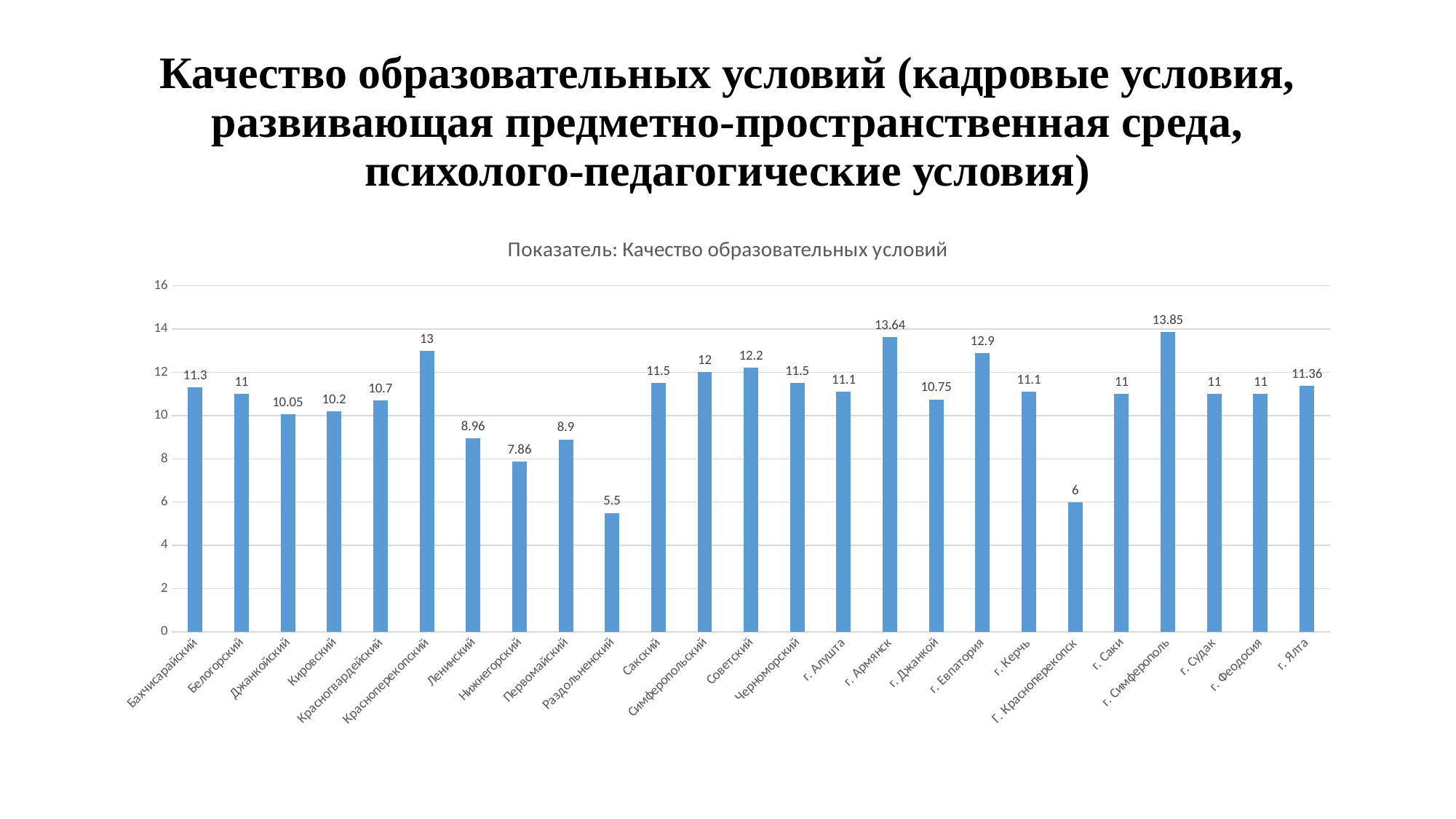
What is the difference between the values for г. Симферополь and Раздольненский? 8.35 What is the value for г. Армянск? 13.64 What is the difference between the values for Красноперекопский and Ленинский? 4.04 What is the value for Нижнегорский? 7.86 What kind of chart is shown on the slide? bar chart Which is larger, the value for Советский or the value for Нижнегорский? Советский Which category has the highest value? г. Симферополь Is the value for г. Красноперекопск greater or less than 8? less Which category has the lowest value? Раздольненский How many categories are shown on the x axis? 25 What is the title of the chart? Показатель: Качество образовательных условий What is the value for Бахчисарайский? 11.3